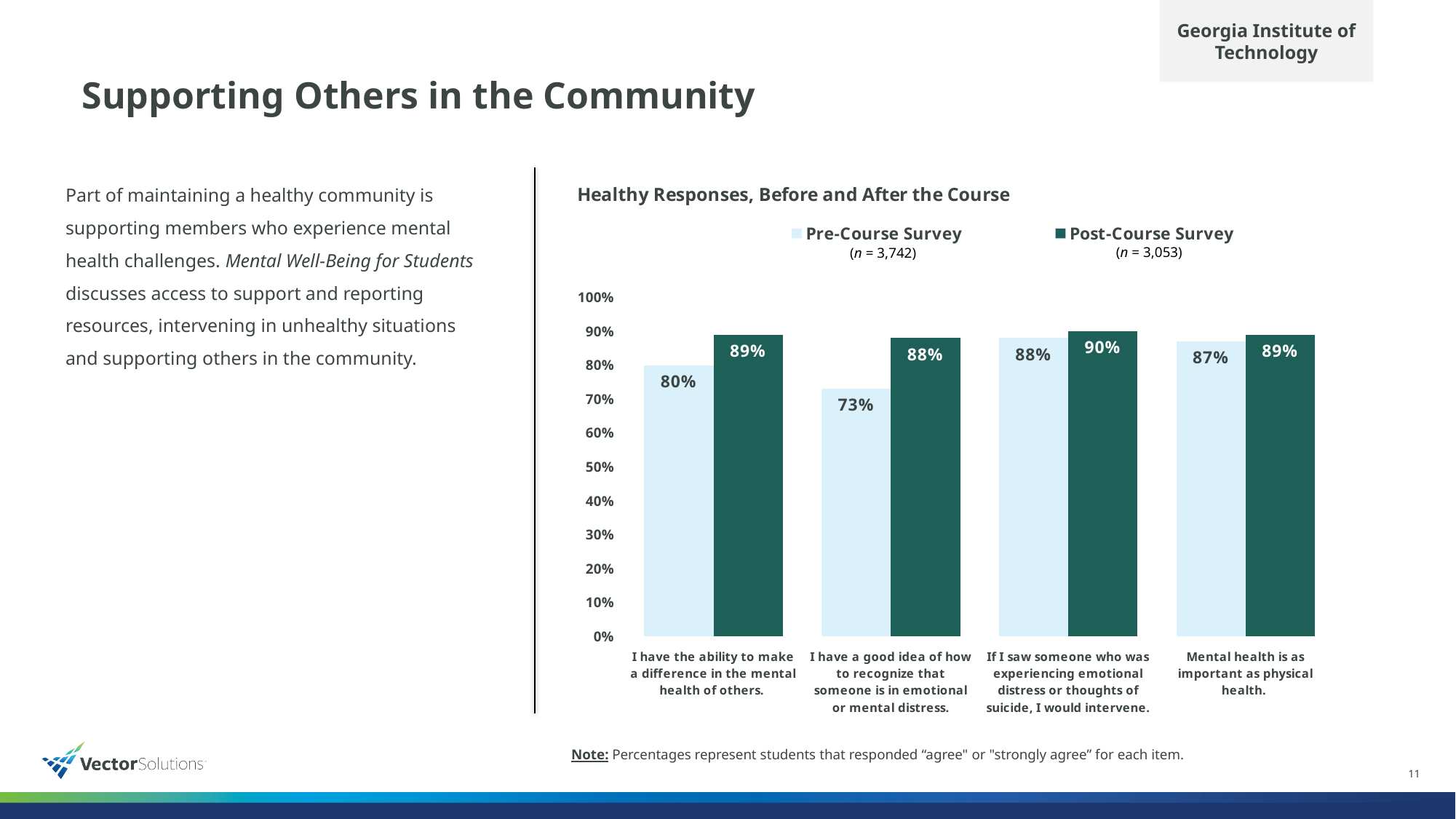
What is the title of the chart? Healthy Responses, Before and After the Course Which is larger for "I have the ability to make a difference in the mental health of others": the Pre-Course Survey value or the Post-Course Survey value? Post-Course Survey What is the Post-Course Survey value for "If I saw someone who was experiencing emotional distress or thoughts of suicide, I would intervene"? 90% What is the difference between the Post-Course and Pre-Course Survey values for "I have the ability to make a difference in the mental health of others"? 9% Which item has the highest Post-Course Survey value? If I saw someone who was experiencing emotional distress or thoughts of suicide, I would intervene. How many series does the chart legend list? 2 What is the Pre-Course Survey value for "Mental health is as important as physical health"? 87% How many survey items are shown on the x axis of the chart? 4 What is the difference between the Post-Course and Pre-Course Survey values for "I have a good idea of how to recognize that someone is in emotional or mental distress"? 15% What is the Pre-Course Survey value for "I have a good idea of how to recognize that someone is in emotional or mental distress"? 73% What type of chart is shown on the slide? Bar chart Which item has the lowest Pre-Course Survey value? I have a good idea of how to recognize that someone is in emotional or mental distress.